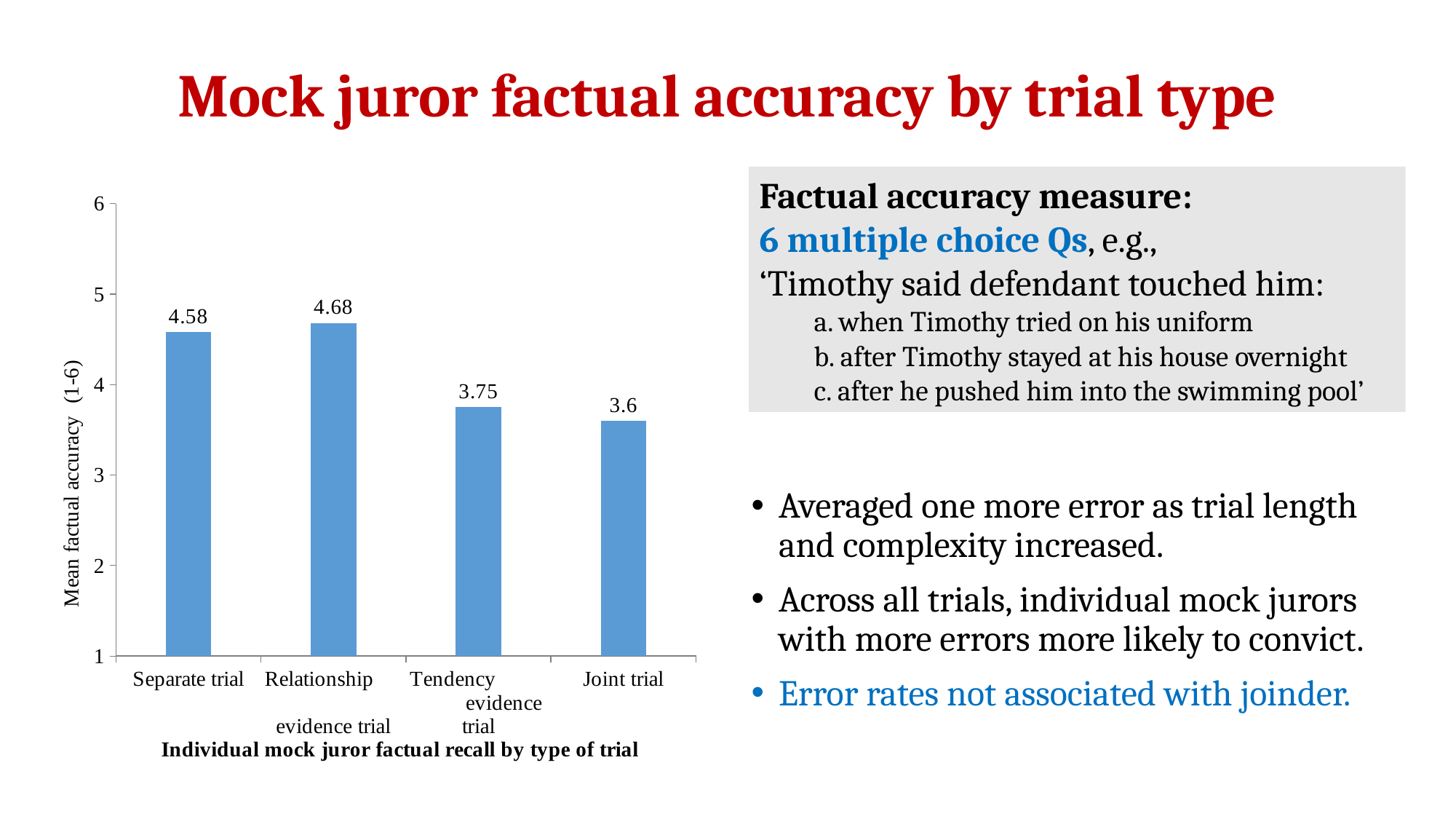
How many trial types are shown on the chart? 4 What is the mean factual accuracy for the Relationship evidence trial? 4.68 What is the mean factual accuracy for the Separate trial? 4.58 What is the label of the vertical axis of the chart? Mean factual accuracy (1-6) Which has a higher mean factual accuracy, the Separate trial or the Tendency evidence trial? Separate trial Which trial type has the highest mean factual accuracy? Relationship evidence trial What is the difference in mean factual accuracy between the Relationship evidence trial and the Joint trial? 1.08 What is the mean factual accuracy for the Joint trial? 3.6 Which trial type has the lowest mean factual accuracy? Joint trial What kind of chart is shown on the slide? Bar chart Is the value for the Joint trial greater or less than 4? less What is the mean factual accuracy for the Tendency evidence trial? 3.75